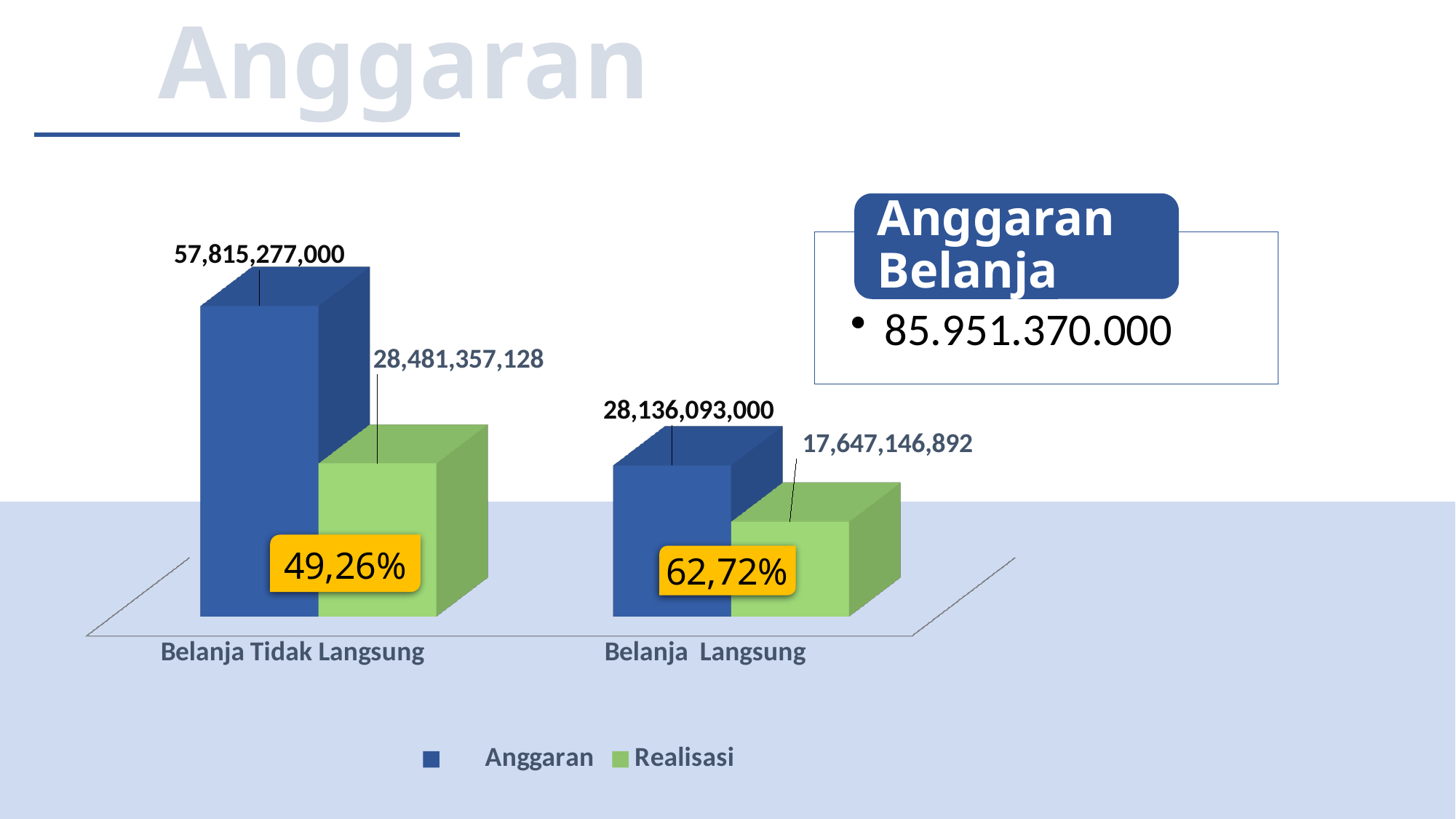
Which category has the lowest Realisasi value? Belanja Langsung What percentage is shown on the label for Belanja Tidak Langsung? 49,26% What percentage is shown on the label for Belanja Langsung? 62,72% Which category has the highest Anggaran value? Belanja Tidak Langsung What is the Anggaran value for Belanja Langsung? 28,136,093,000 Is the Anggaran value for Belanja Langsung larger or smaller than the Realisasi value for Belanja Tidak Langsung? smaller What is the Realisasi value for Belanja Langsung? 17,647,146,892 What kind of chart is shown on the slide? Bar chart What is the Anggaran value for Belanja Tidak Langsung? 57,815,277,000 What is the Realisasi value for Belanja Tidak Langsung? 28,481,357,128 What is the difference between the Anggaran and Realisasi values for Belanja Tidak Langsung? 29,333,919,872 How many series does the legend list? 2